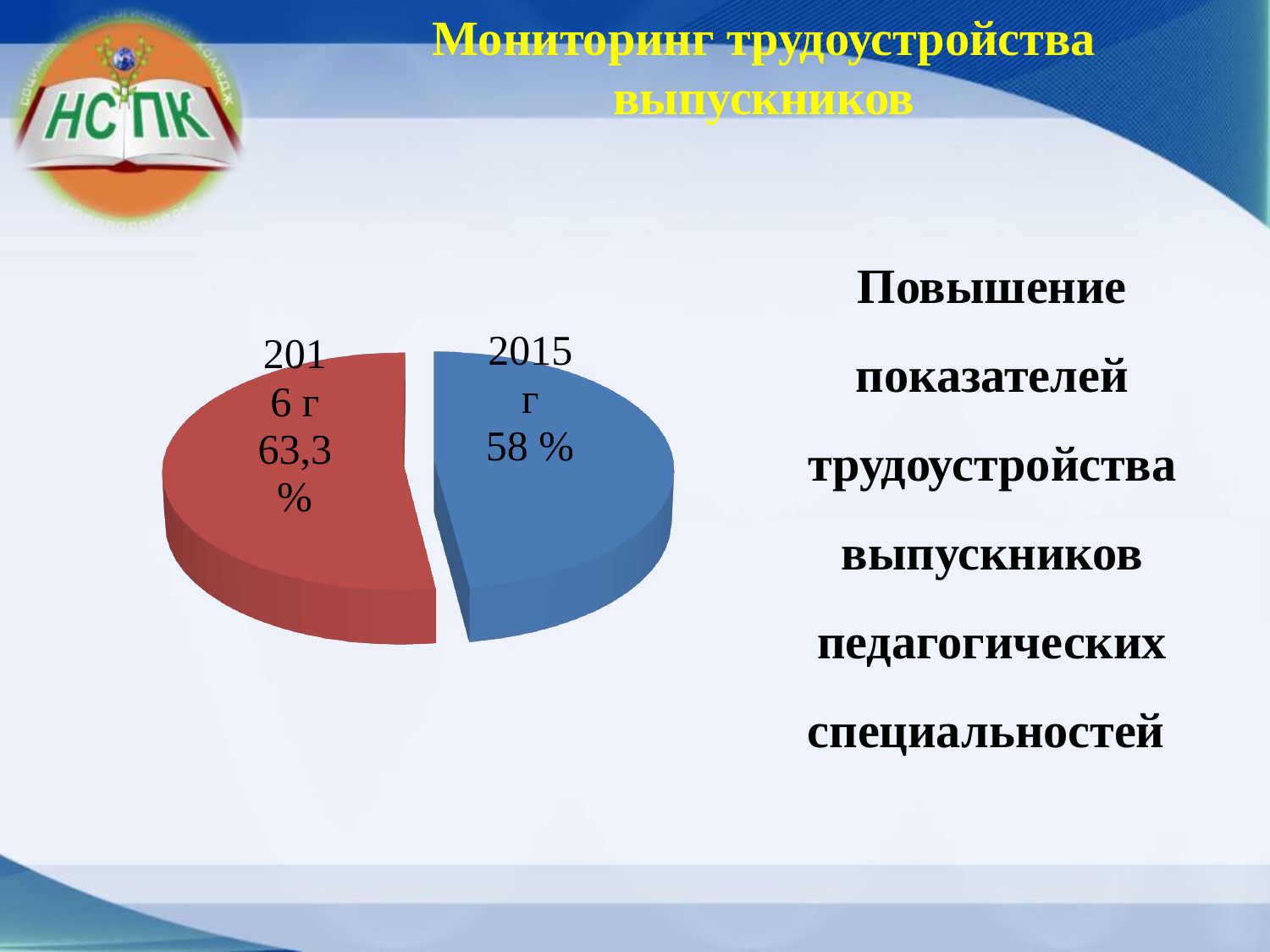
How many slices does the pie chart have? 2 What colour is the slice for 2016 г? red What colour is the slice for 2015 г? blue By how many percentage points does the 2016 г value exceed the 2015 г value? 5,3 Which year has the higher value in the pie chart? 2016 г Is the value for 2016 г larger or smaller than the value for 2015 г? larger What value is shown for 2015 г in the pie chart? 58 % Which year has the lower value in the pie chart? 2015 г Does the value rise or fall from 2015 г to 2016 г? rise What kind of chart is shown on the slide? pie chart What value is shown for 2016 г in the pie chart? 63,3 %